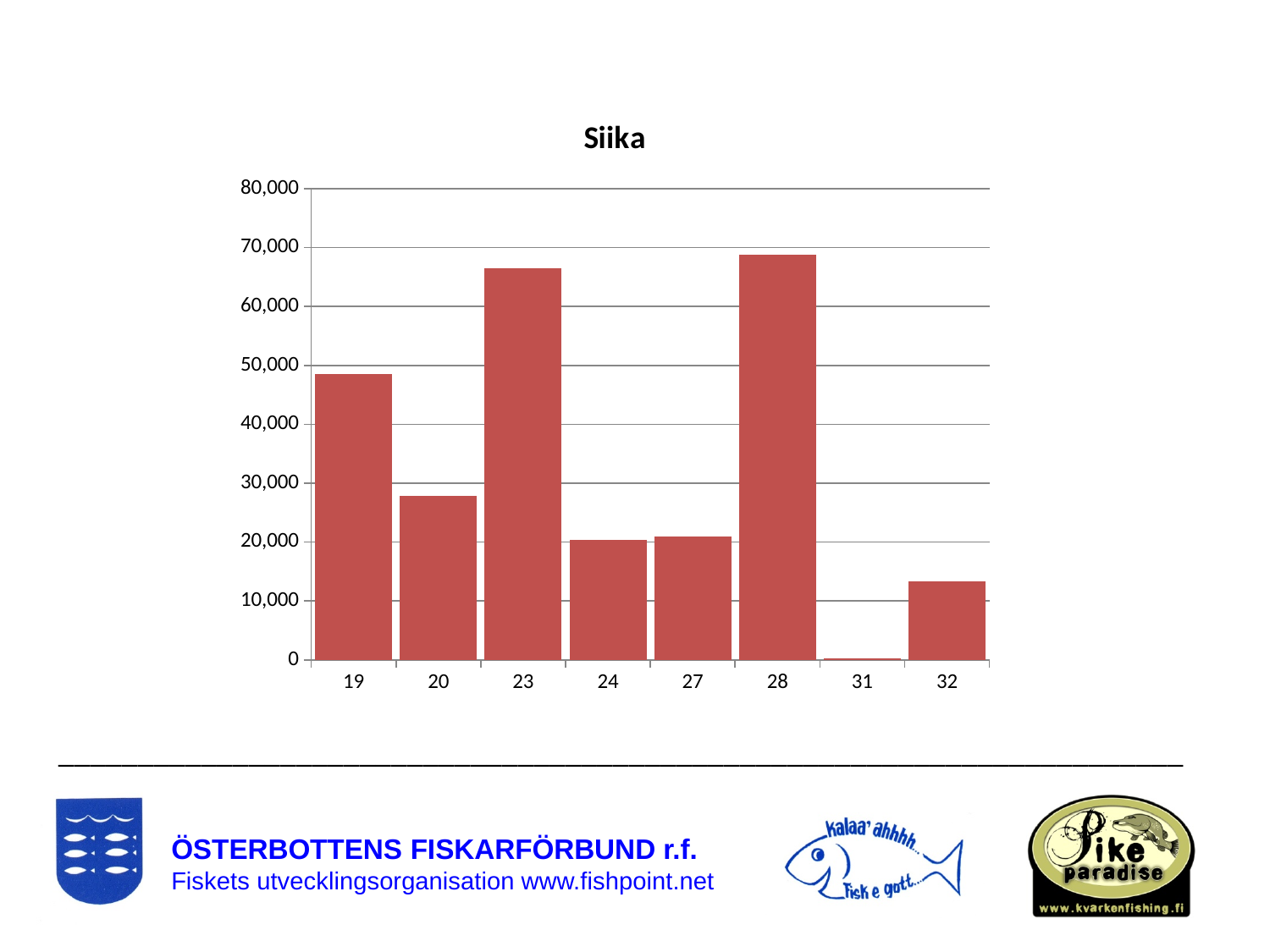
Is the value for category 32 greater or less than 10,000? greater Is the value for category 23 greater or less than 60,000? greater Is the value for category 19 greater or less than 40,000? greater Which has the larger value, category 23 or category 24? 23 What kind of chart is shown on the slide? bar chart Which category has the lowest bar in the chart? 31 What is the title of the chart? Siika How many categories are shown on the x axis of the chart? 8 Which category has the highest bar in the chart? 28 What colour are the bars in the chart? red Which has the larger value, category 19 or category 20? 19